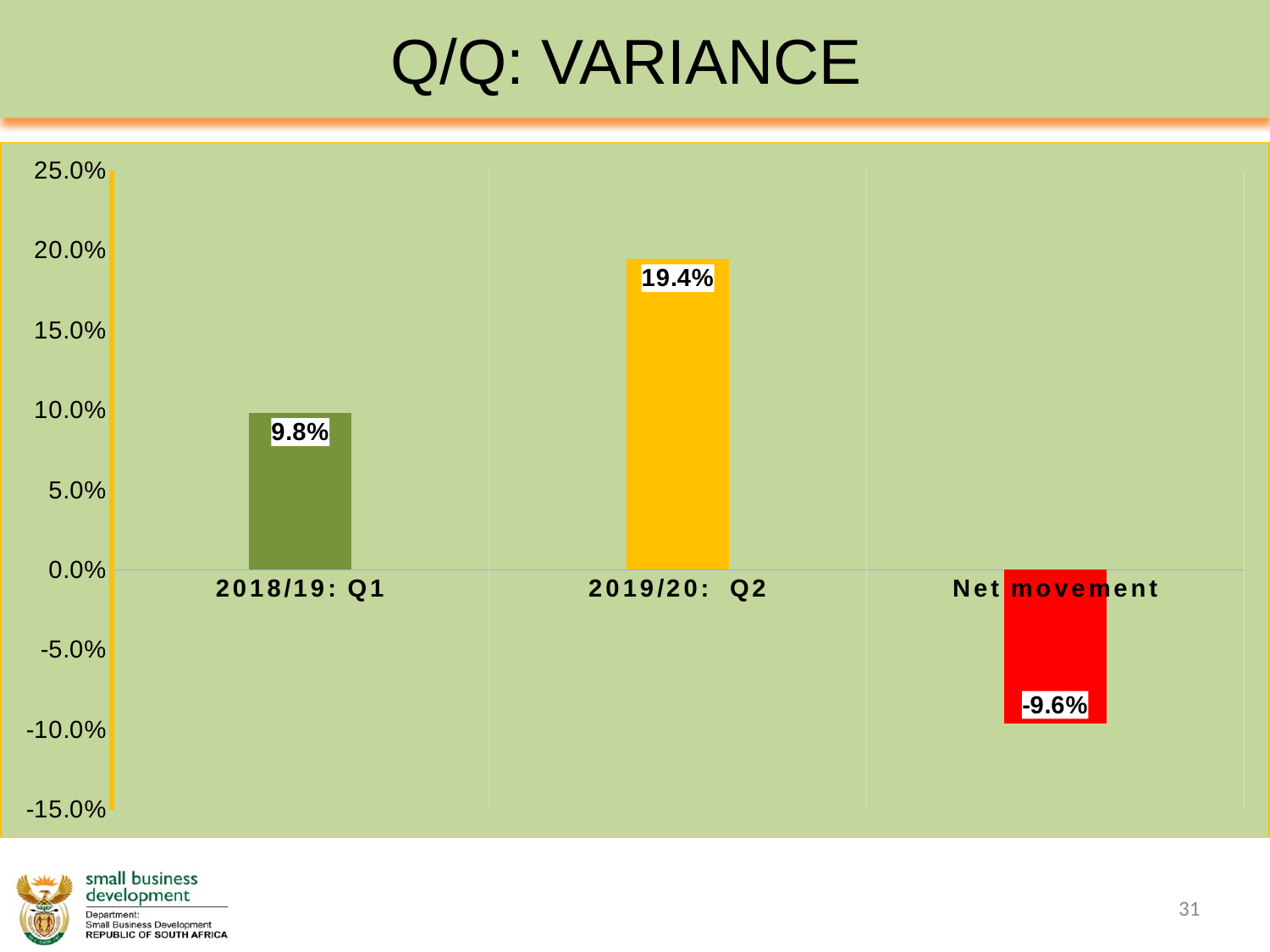
Is the value for 2019/20: Q2 greater or less than 15.0%? greater What is the title of the slide? Q/Q: VARIANCE Which category has the highest value? 2019/20: Q2 Is the value for Net movement greater or less than 0.0%? less What kind of chart is shown on the slide? bar chart What is the value for 2018/19: Q1? 9.8% Which is larger, the value for 2018/19: Q1 or the value for 2019/20: Q2? 2019/20: Q2 What is the value for Net movement? -9.6% Which category has the lowest value? Net movement How many categories are shown on the chart? 3 What is the value for 2019/20: Q2? 19.4% What is the difference between the values for 2019/20: Q2 and 2018/19: Q1? 9.6%